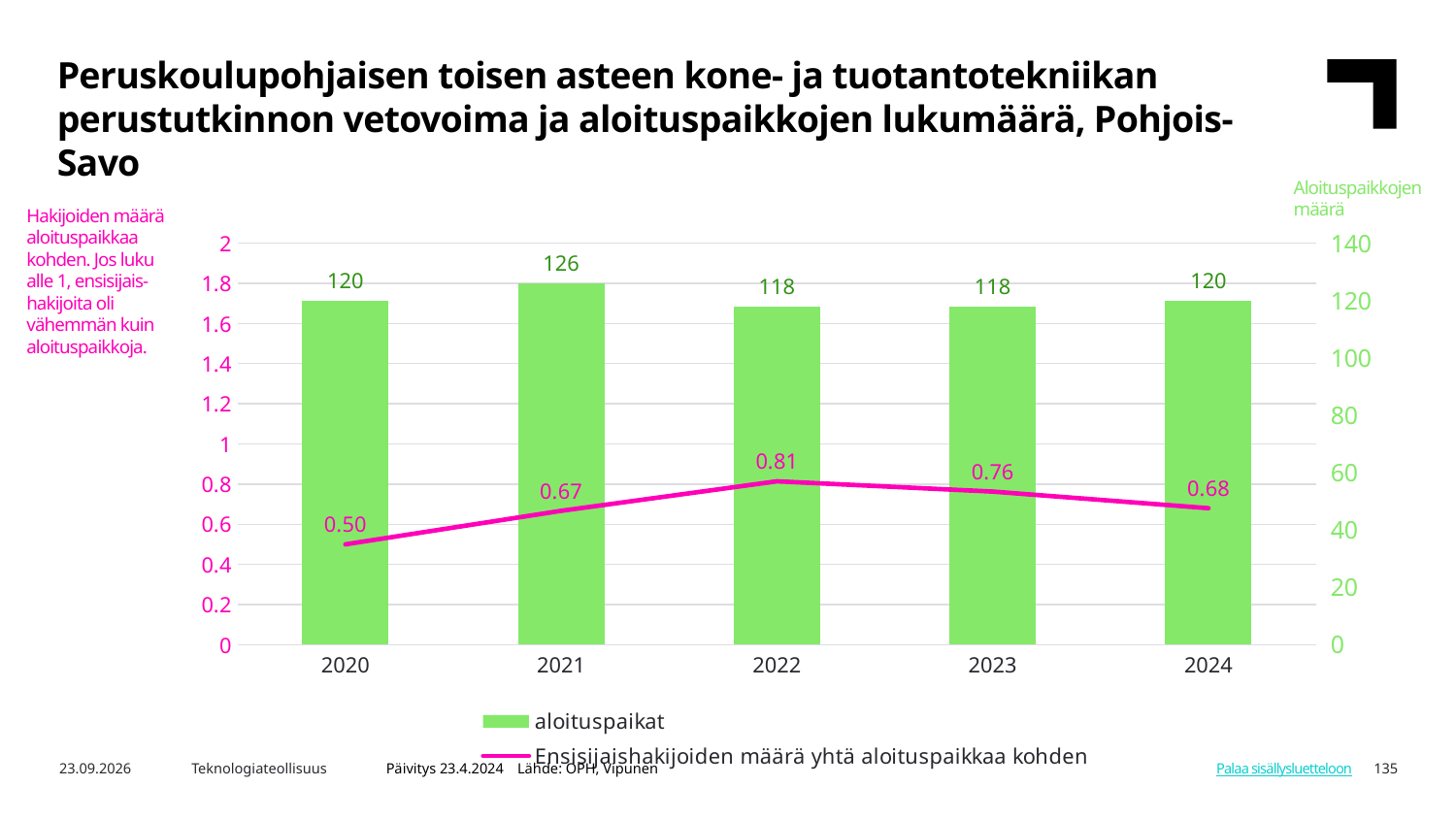
What is the value of aloituspaikat for 2024? 120 What is the difference between the aloituspaikat values for 2021 and 2022? 8 Which year has the lowest value of Ensisijaishakijoiden määrä yhtä aloituspaikkaa kohden? 2020 How many series does the legend list? 2 What is the value of aloituspaikat for 2021? 126 What is the value of Ensisijaishakijoiden määrä yhtä aloituspaikkaa kohden for 2020? 0.50 How many years are shown on the x axis of the chart? 5 What is the value of Ensisijaishakijoiden määrä yhtä aloituspaikkaa kohden for 2022? 0.81 Which year has the highest value of aloituspaikat? 2021 Which is larger, the Ensisijaishakijoiden määrä yhtä aloituspaikkaa kohden value for 2023 or for 2024? 2023 Does the Ensisijaishakijoiden määrä yhtä aloituspaikkaa kohden line rise or fall from 2020 to 2022? rise What colour are the aloituspaikat bars? green